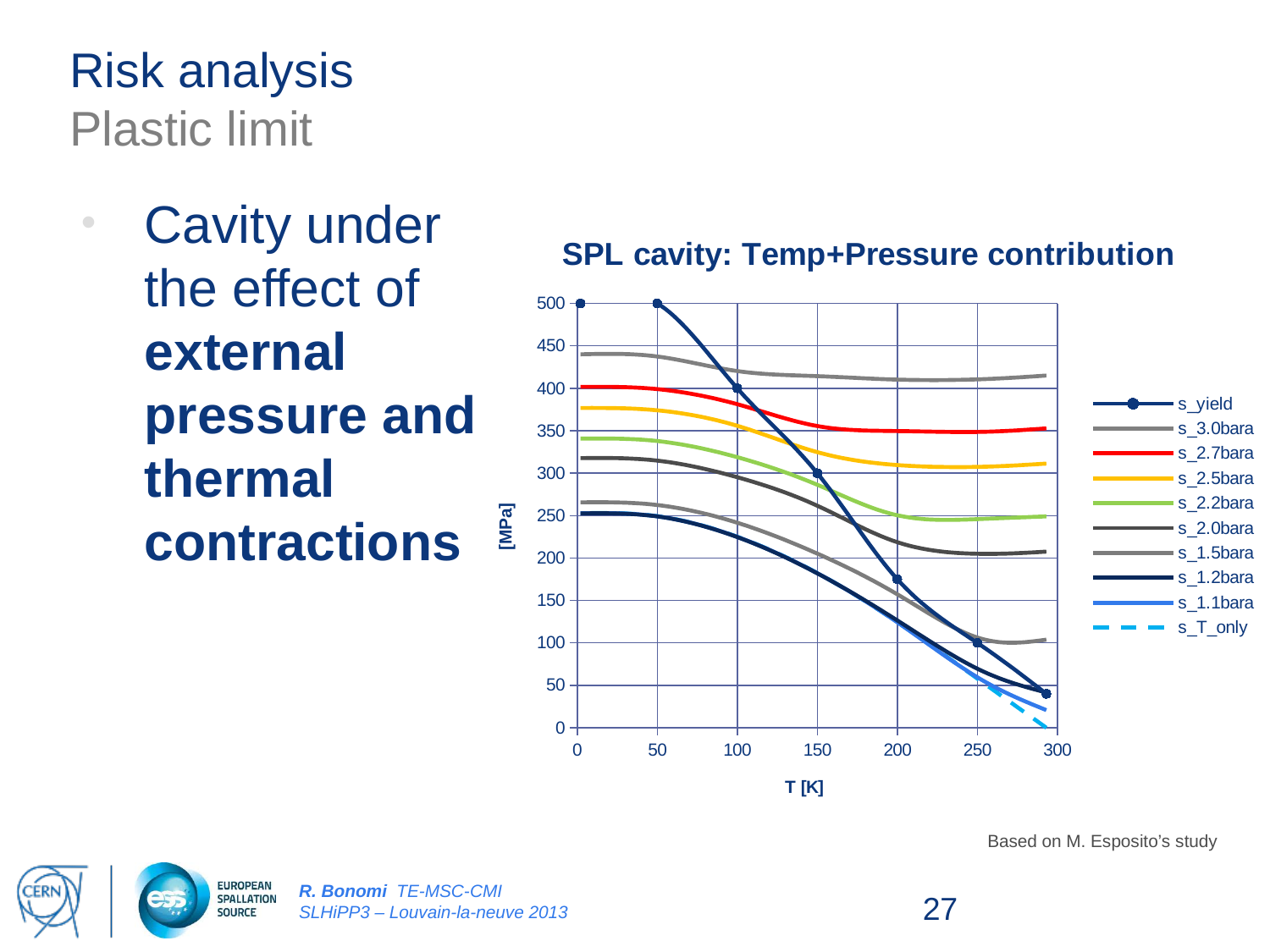
What is the label of the y axis? [MPa] Is the value for s_3.0bara at T = 0 K greater or less than 400? greater What type of chart is shown on the slide? line chart What is the title of the chart? SPL cavity: Temp+Pressure contribution Is the value for s_1.1bara at T = 300 K greater or less than 50? less How many series does the chart legend list? 10 What is the value of s_yield at T = 0 K? 500 Which series has the lowest value at T = 300 K? s_T_only Does the s_yield series rise or fall as T increases from 50 K to 300 K? fall What is the value of s_yield at T = 50 K? 500 At T = 200 K, which is larger: s_3.0bara or s_1.2bara? s_3.0bara Which series has the highest value at T = 0 K? s_yield